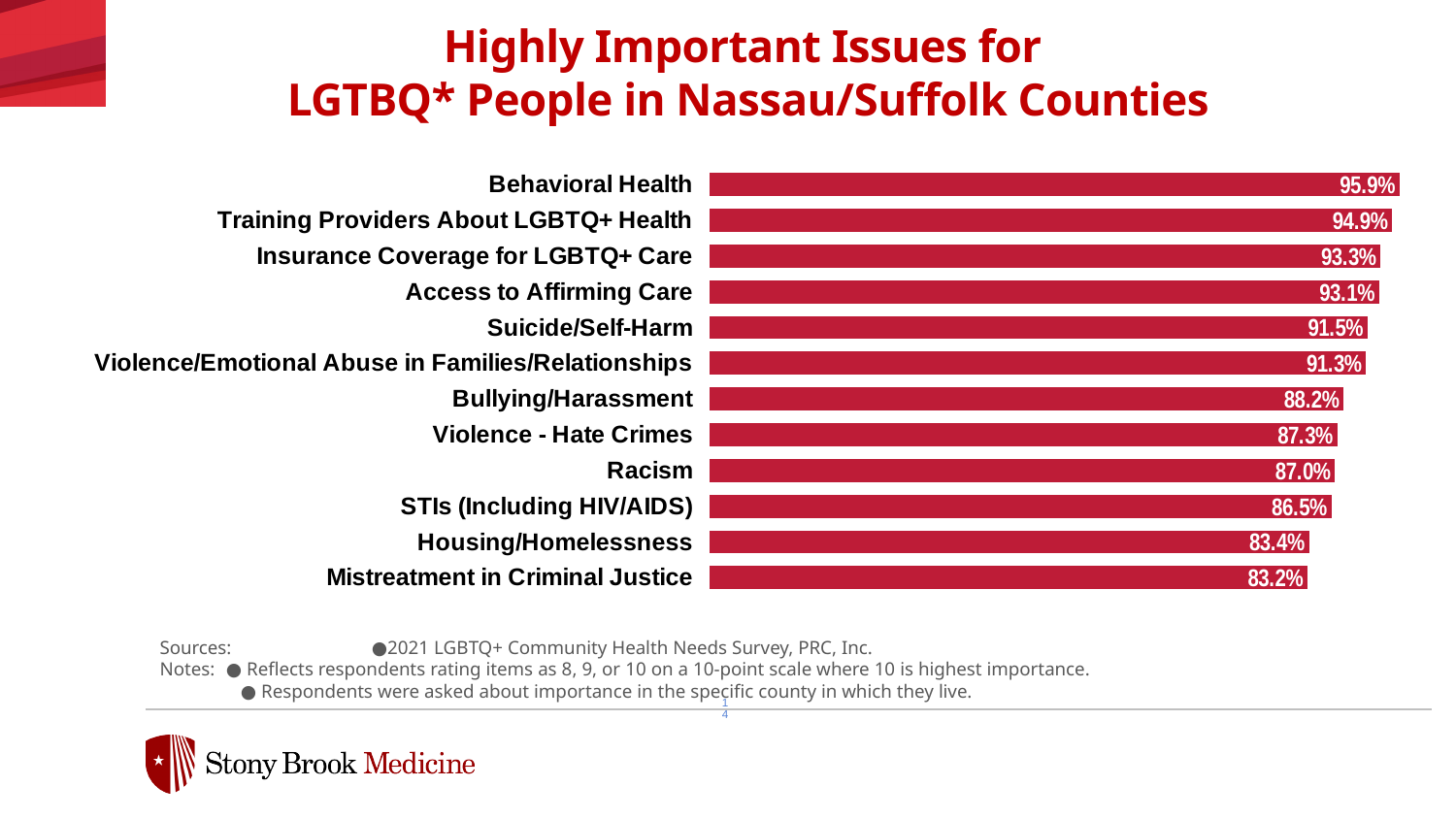
Which issue has the lowest percentage on the chart? Mistreatment in Criminal Justice How many issues are listed on the chart? 12 Do the values increase or decrease going from the top bar to the bottom bar? Decrease What percentage of respondents rated Behavioral Health as highly important? 95.9% What is the title of the chart on the slide? Highly Important Issues for LGTBQ* People in Nassau/Suffolk Counties What is the value shown for Housing/Homelessness? 83.4% What is the difference between the values for Bullying/Harassment and STIs (Including HIV/AIDS)? 1.7 percentage points Which has a higher value: Suicide/Self-Harm or Violence - Hate Crimes? Suicide/Self-Harm What is the difference between the values for Behavioral Health and Mistreatment in Criminal Justice? 12.7 percentage points What type of chart is shown on the slide? Bar chart Which issue has the highest percentage on the chart? Behavioral Health What is the value shown for Racism? 87.0%